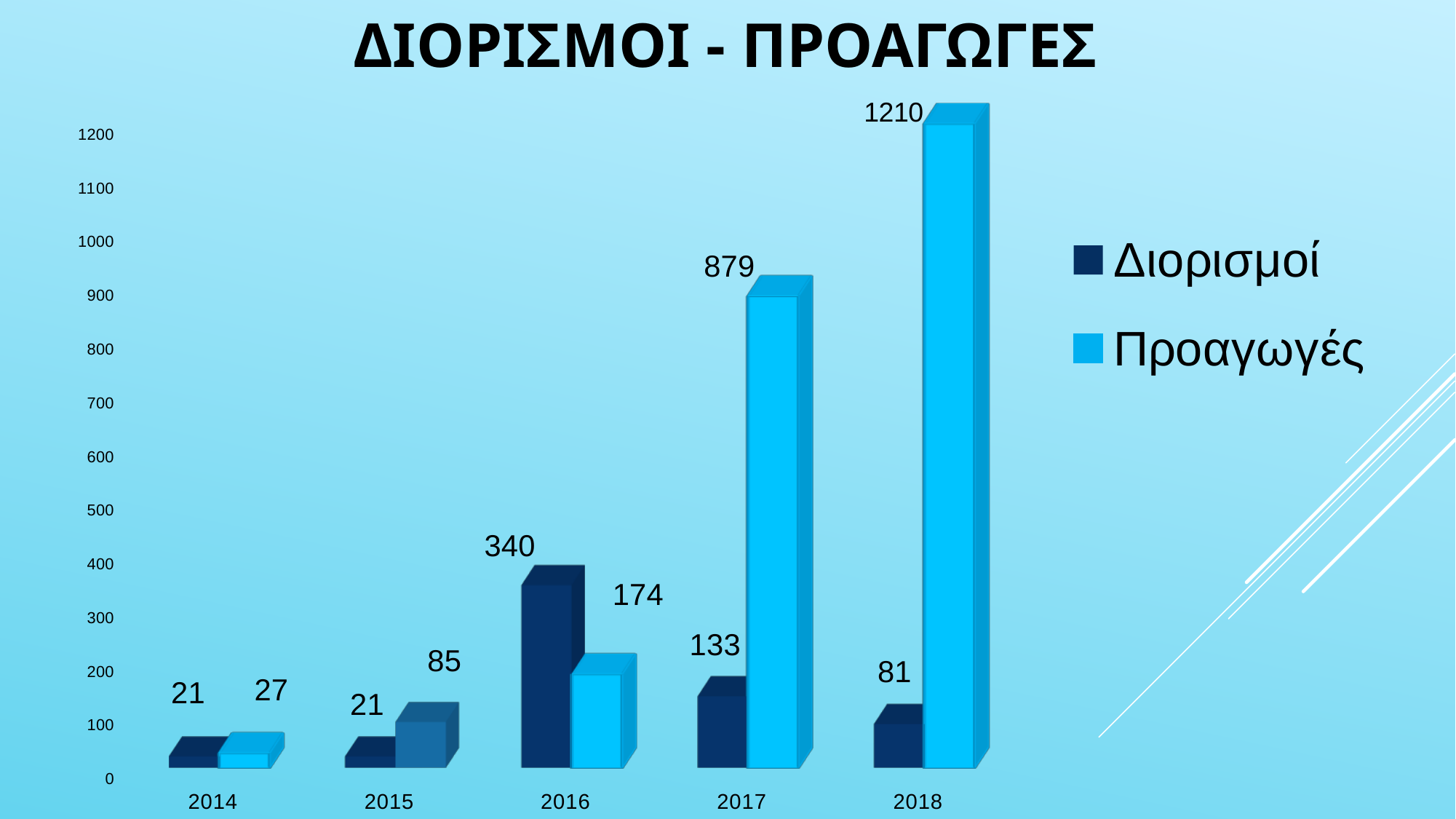
What is the value for Προαγωγές in 2015? 85 Which year has the highest value for Προαγωγές? 2018 How many years are shown on the x axis? 5 Which is larger in 2017: Διορισμοί or Προαγωγές? Προαγωγές What kind of chart is shown on the slide? Bar chart What is the difference between Προαγωγές in 2018 and Προαγωγές in 2017? 331 What is the difference between Διορισμοί and Προαγωγές in 2016? 166 Which year has the lowest value for Προαγωγές? 2014 What is the value for Διορισμοί in 2016? 340 Which year has the highest value for Διορισμοί? 2016 How many series does the legend list? 2 What is the value for Προαγωγές in 2018? 1210